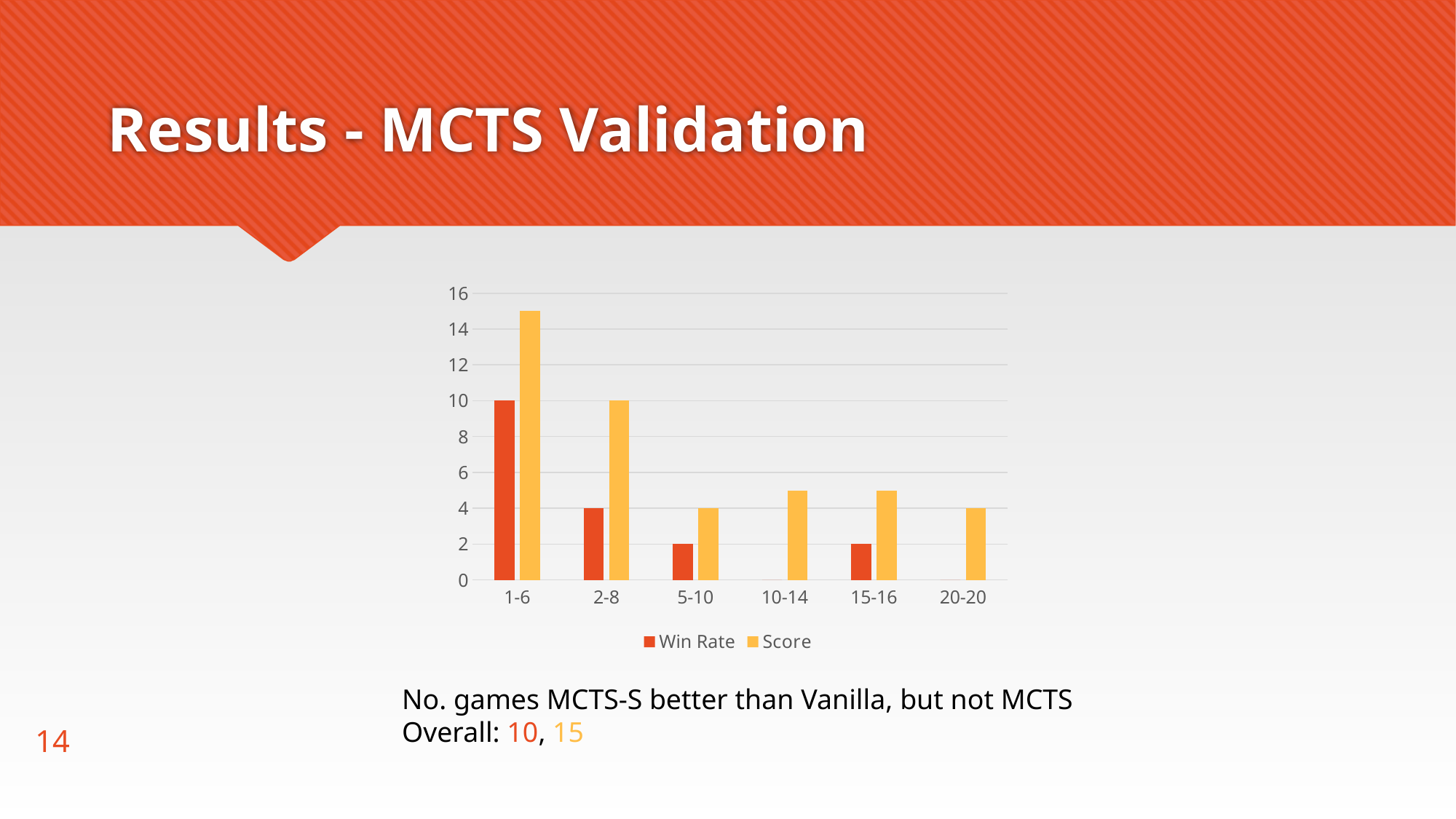
Is the Score value for the 1-6 category greater or less than 14? greater What is the Score value for the 2-8 category? 10 What is the difference between the Score and Win Rate values for the 2-8 category? 6 What is the Win Rate value for the 2-8 category? 4 What type of chart is shown on the slide? bar chart Which category has the highest Score value? 1-6 How many series does the chart legend list? 2 Which category has the highest Win Rate value? 1-6 What is the Score value for the 20-20 category? 4 What is the Win Rate value for the 1-6 category? 10 Which is larger for the 10-14 category, Win Rate or Score? Score How many categories are shown on the x axis of the chart? 6